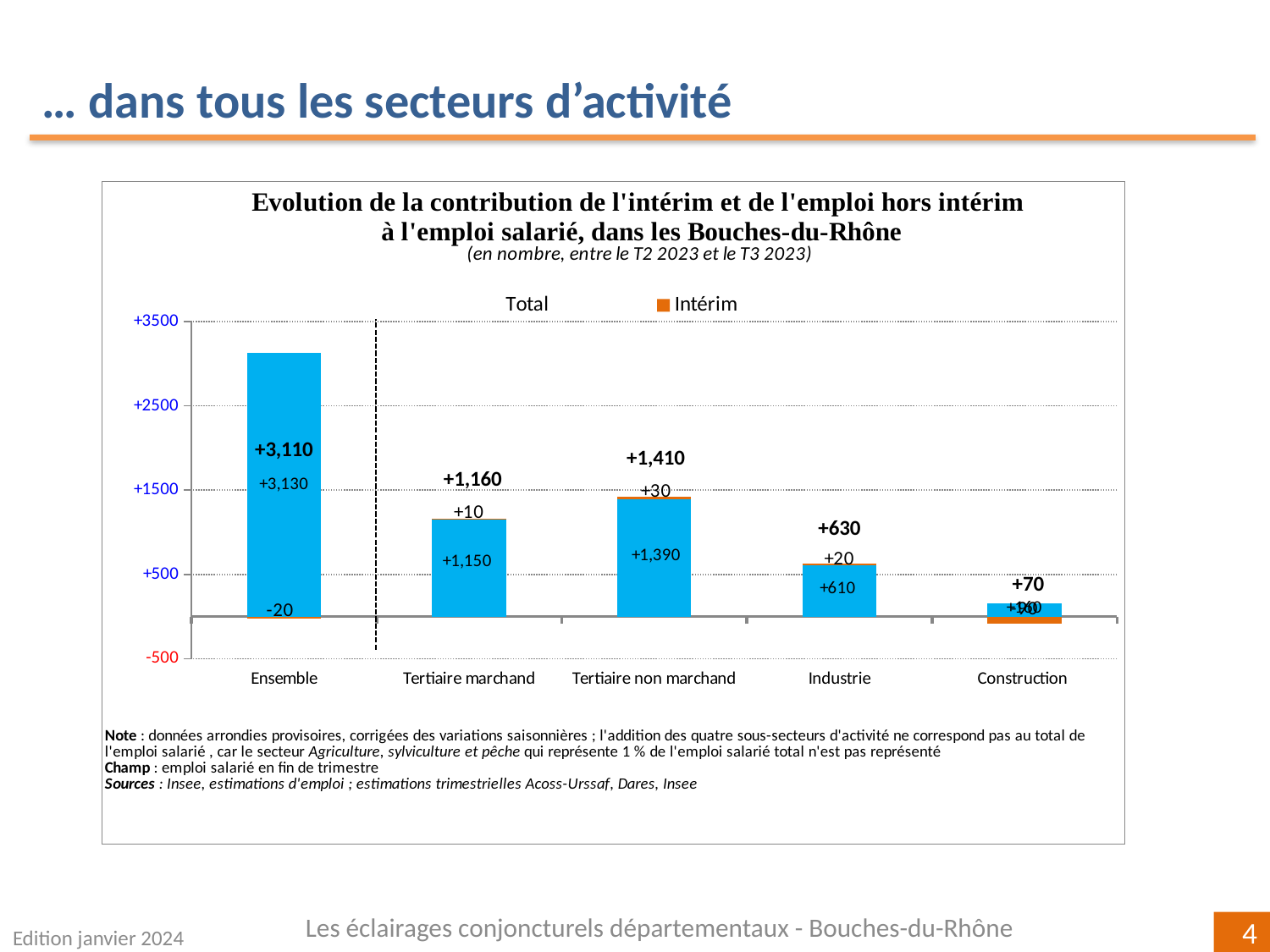
How many series does the legend list? 2 What is the total value shown for Industrie? +630 What is the value of the blue segment for Tertiaire marchand? +1,150 What kind of chart is this? Bar chart How many categories are shown on the x axis? 5 What is the total value shown above the bar for Ensemble? +3,110 Which category has the highest total? Ensemble Which category has the lowest total? Construction What is the Intérim value for Tertiaire non marchand? +30 Which has the larger total, Tertiaire non marchand or Industrie? Tertiaire non marchand What is the Intérim value for Ensemble? -20 What is the difference between the totals for Tertiaire non marchand and Tertiaire marchand? 250